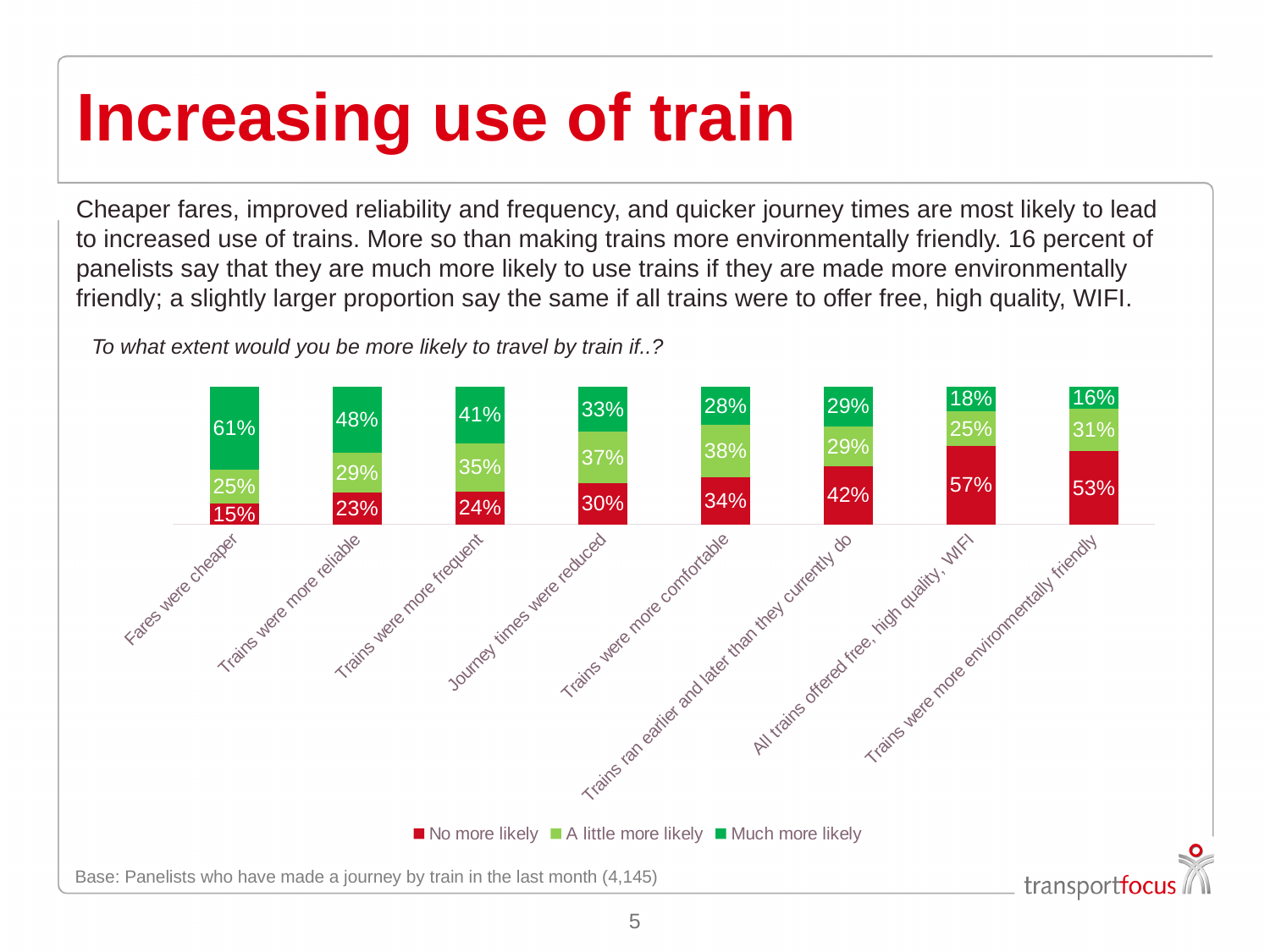
Which series is shown in red in the chart? No more likely Which category has the highest 'Much more likely' value? Fares were cheaper Which category has the lowest 'No more likely' value? Fares were cheaper How many series does the legend list? 3 How many categories are shown on the x axis of the chart? 8 What percentage of panelists said they would be much more likely to travel by train if fares were cheaper? 61% What is the 'No more likely' value for 'All trains offered free, high quality, WIFI'? 57% What is the 'A little more likely' value for 'Trains were more comfortable'? 38% Does the 'Much more likely' value rise or fall moving from left to right across the categories? Fall What kind of chart is shown on the slide? Stacked bar chart Which is larger: the 'No more likely' value for 'Journey times were reduced' or for 'Trains were more frequent'? Journey times were reduced What is the difference between the 'Much more likely' values for 'Trains were more reliable' and 'Trains were more environmentally friendly'? 32 percentage points